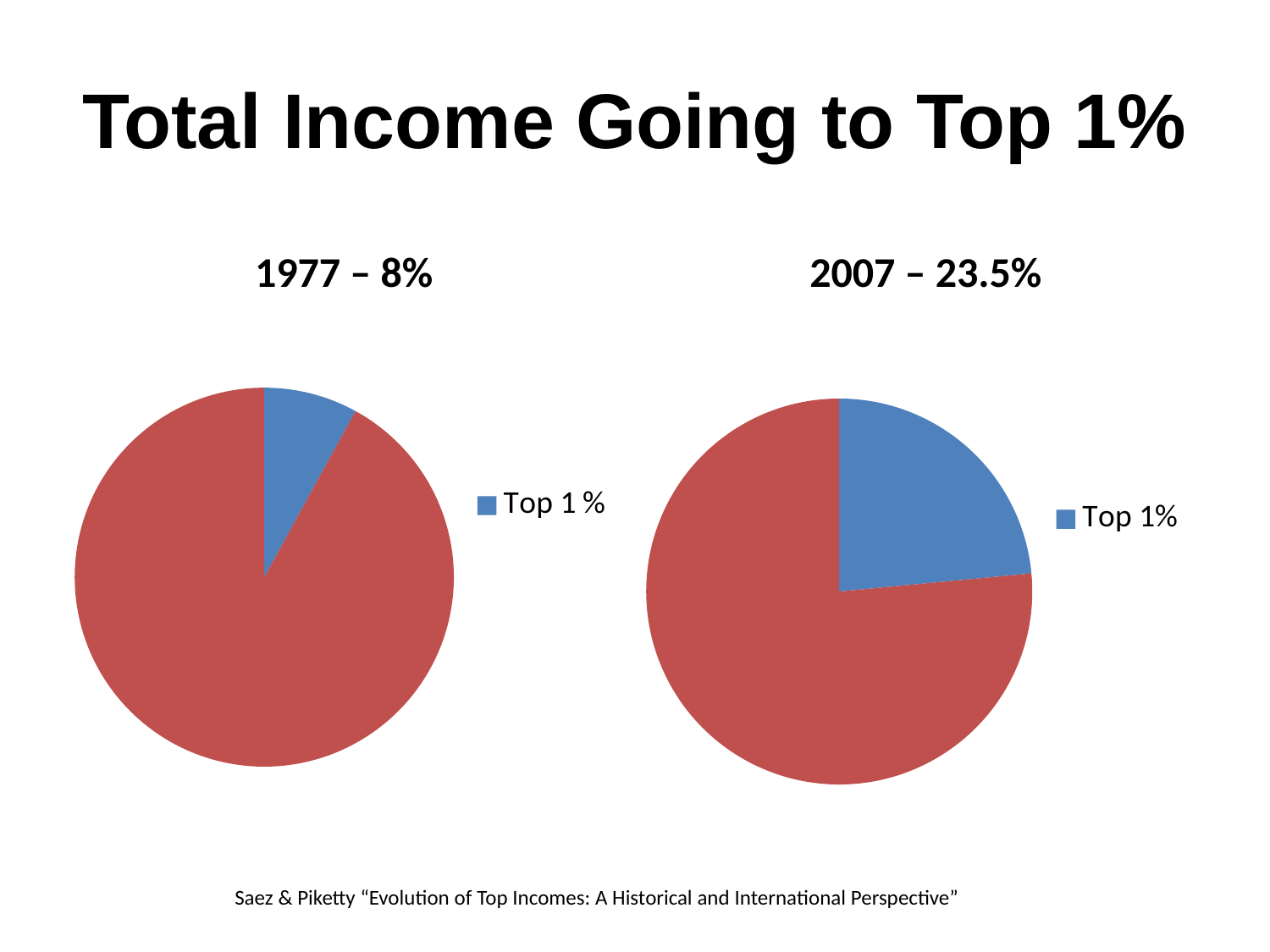
How many slices does the left chart titled "1977 – 8%" have? 2 How many entries does the legend of the right chart titled "2007 – 23.5%" list? 1 In the left chart titled "1977 – 8%", what share of total income went to the Top 1%? 8% By how many percentage points did the Top 1% share of income in the 2007 chart exceed the share in the 1977 chart? 15.5% How many slices does the right chart titled "2007 – 23.5%" have? 2 In the right chart titled "2007 – 23.5%", what share of total income went to the Top 1%? 23.5% What is the legend entry shown next to the right chart titled "2007 – 23.5%"? Top 1% What kind of chart is the right chart titled "2007 – 23.5%"? pie chart What kind of chart is the left chart titled "1977 – 8%"? pie chart What colour is the Top 1% slice in the left chart titled "1977 – 8%"? blue In the left chart titled "1977 – 8%", is the Top 1% share greater or less than 10%? less Comparing the two pie charts, which year shows the larger share of income going to the Top 1%, 1977 or 2007? 2007